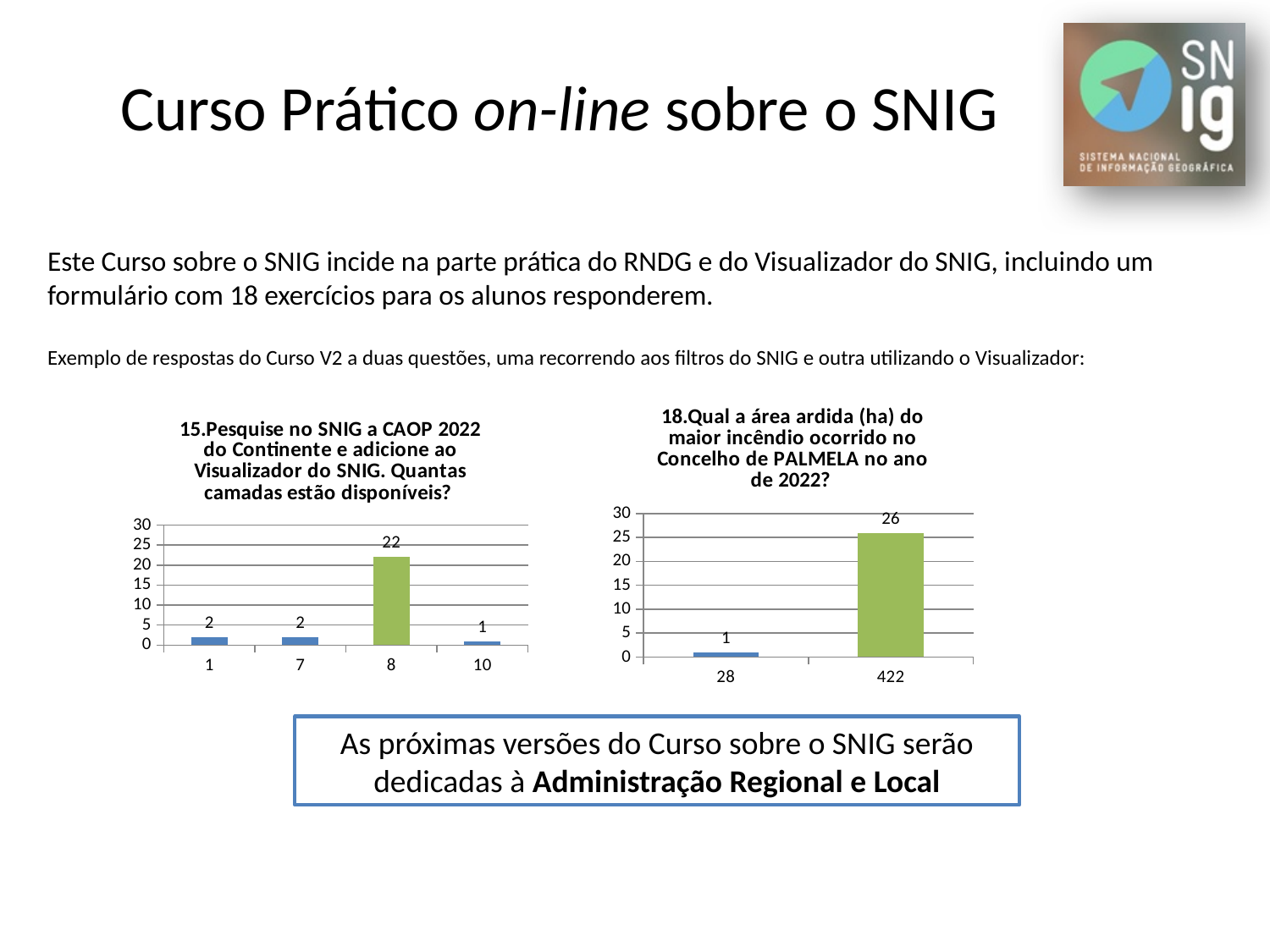
In the left chart (question 15), how many categories are shown on the x axis? 4 In the right chart (question 18), what is the value for the category 422? 26 In the left chart (question 15), what is the value for the category 10? 1 In the left chart (question 15), which category has the highest value? 8 In the left chart (question 15), is the value for category 8 greater or less than 20? greater In the right chart (question 18), which category has the higher value, 28 or 422? 422 In the left chart (question 15), which category has the lowest value? 10 In the right chart (question 18), what is the value for the category 28? 1 What type of chart is the right chart (question 18)? Bar chart In the right chart (question 18), what is the difference between the values for 422 and 28? 25 In the left chart (question 15), what is the value for the category 8? 22 In the left chart (question 15), what is the difference between the values for category 8 and category 1? 20